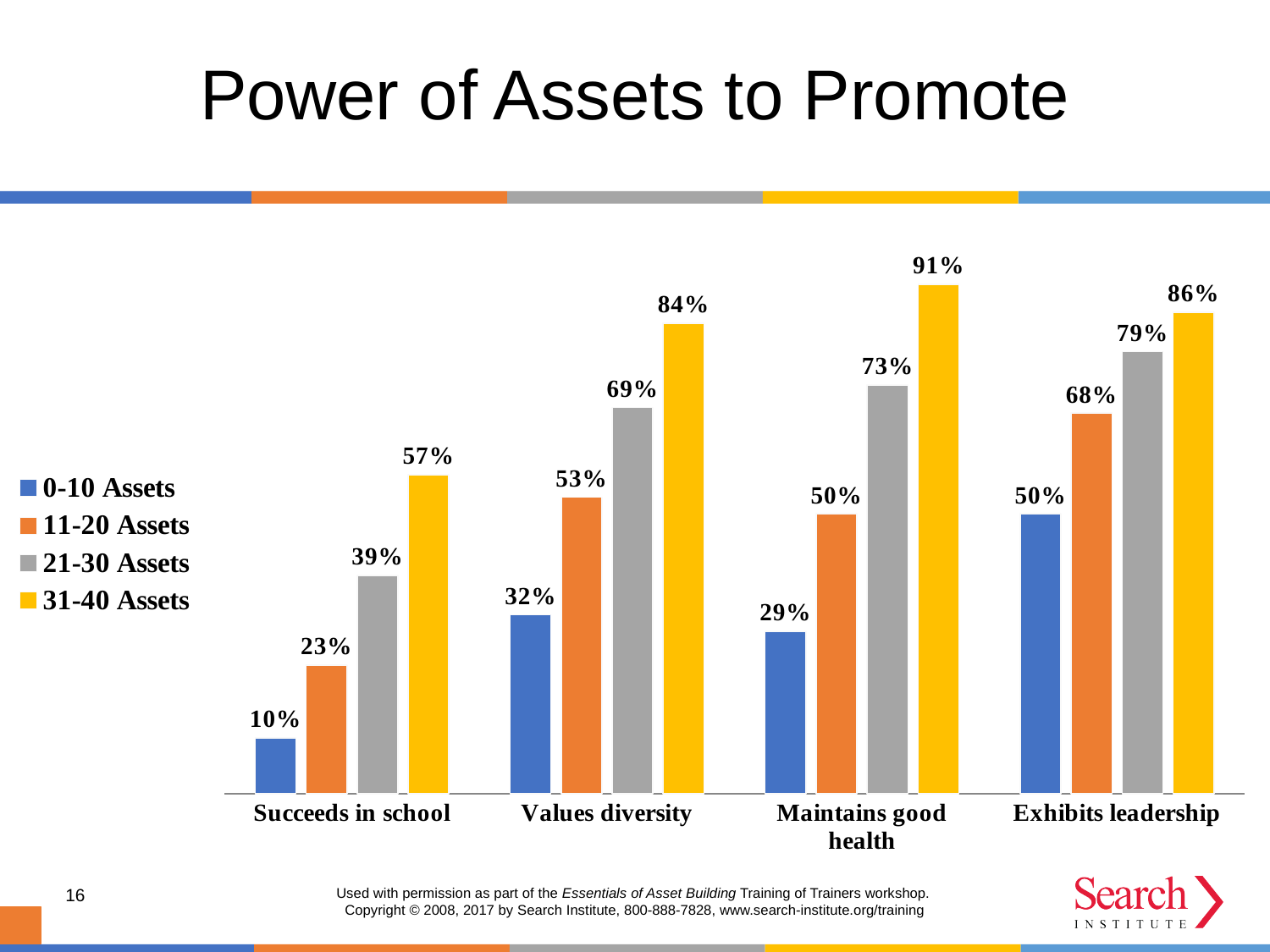
What is the value for 11-20 Assets in the Exhibits leadership category? 68% Which colour represents the 31-40 Assets series? Yellow Which category has the lowest value for 0-10 Assets? Succeeds in school Which is larger: the 21-30 Assets value for Exhibits leadership or the 21-30 Assets value for Maintains good health? Exhibits leadership What is the value for 0-10 Assets in the Succeeds in school category? 10% What kind of chart is shown on the slide? Bar chart How many categories are shown on the x axis? 4 What is the value for 31-40 Assets in the Maintains good health category? 91% What is the difference between the 31-40 Assets and 0-10 Assets values for Succeeds in school? 47% Which category has the highest value for 31-40 Assets? Maintains good health How many series does the legend list? 4 What is the value for 21-30 Assets in the Values diversity category? 69%